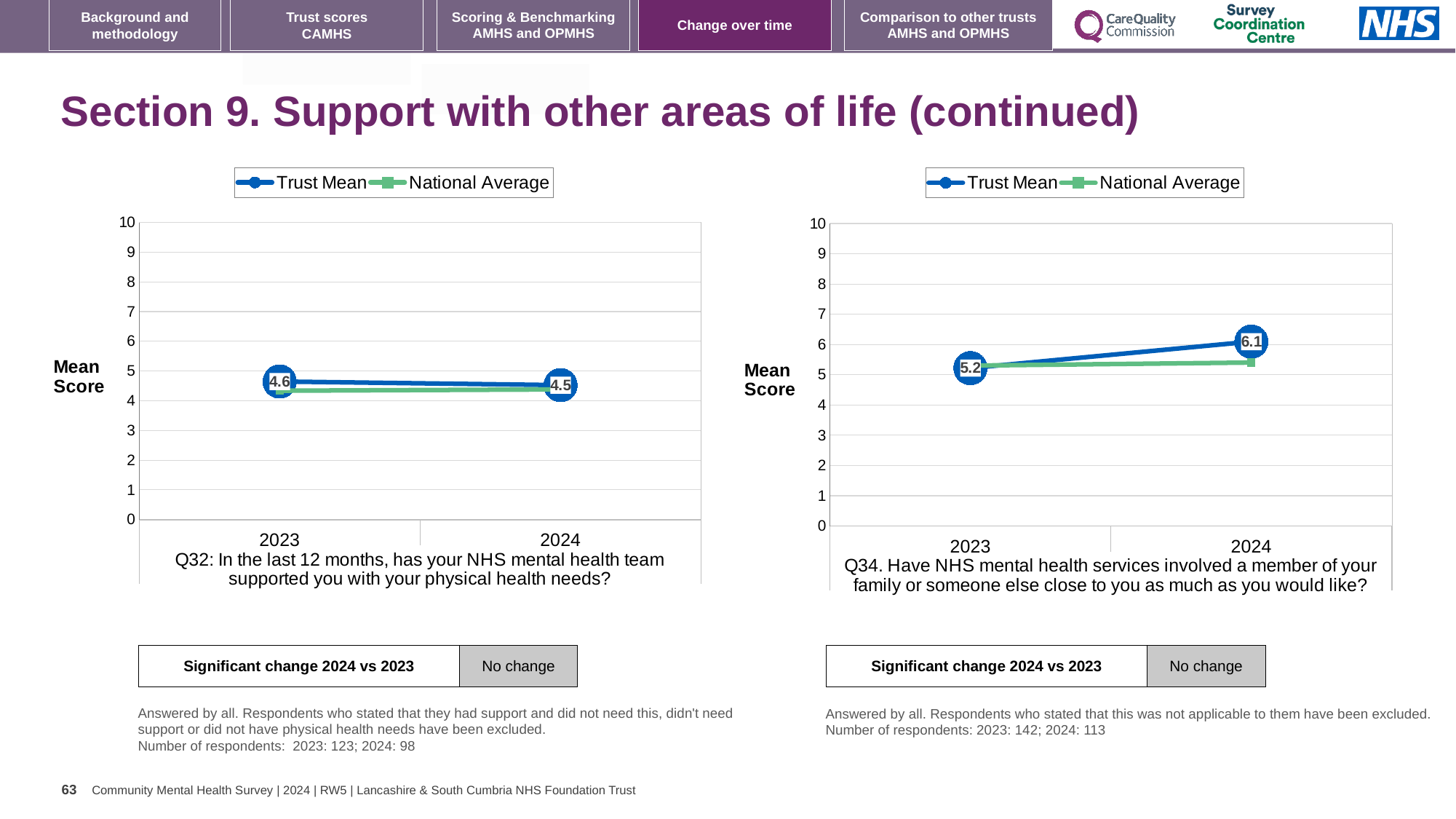
In the right chart (Q34), is the Trust Mean for 2024 larger or smaller than the Trust Mean for 2023? larger In the left chart (Q32), what is the difference between the Trust Mean in 2023 and in 2024? 0.1 What kind of chart is the left chart (Q32)? line chart In the right chart (Q34), what is the Trust Mean for 2024? 6.1 In the left chart (Q32), is the National Average for 2024 greater or less than 5? less In the left chart (Q32), what is the Trust Mean for 2024? 4.5 In the right chart (Q34), does the Trust Mean rise or fall from 2023 to 2024? rise In the right chart (Q34), by how much did the Trust Mean change from 2023 to 2024? 0.9 In the left chart (Q32), does the Trust Mean rise or fall from 2023 to 2024? fall How many series does the legend of the right chart (Q34) list? 2 In the left chart (Q32), what is the Trust Mean for 2023? 4.6 In the right chart (Q34), what is the Trust Mean for 2023? 5.2